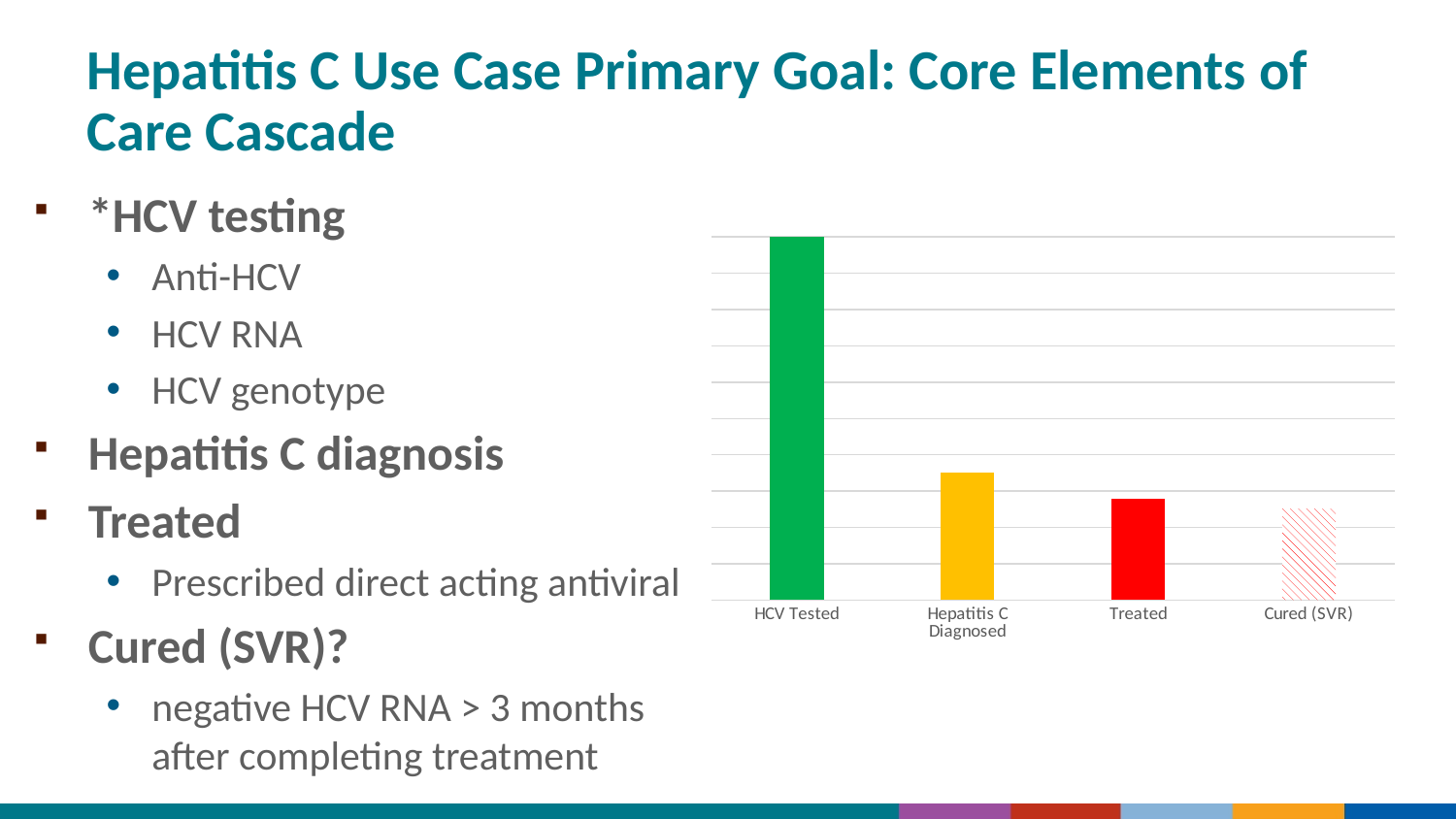
Which category's bar is drawn with a hatched (striped) pattern rather than a solid fill? Cured (SVR) Which bar is taller, Treated or Cured (SVR)? Treated What kind of chart is shown on the slide? bar chart Which bar is taller, HCV Tested or Treated? HCV Tested Which category has the tallest bar in the chart? HCV Tested Do the bar heights rise or fall moving from left to right across the chart? fall What colour is the HCV Tested bar? green Which category has the shortest bar in the chart? Cured (SVR) Which bar is taller, HCV Tested or Hepatitis C Diagnosed? HCV Tested How many categories are shown on the x axis of the chart? 4